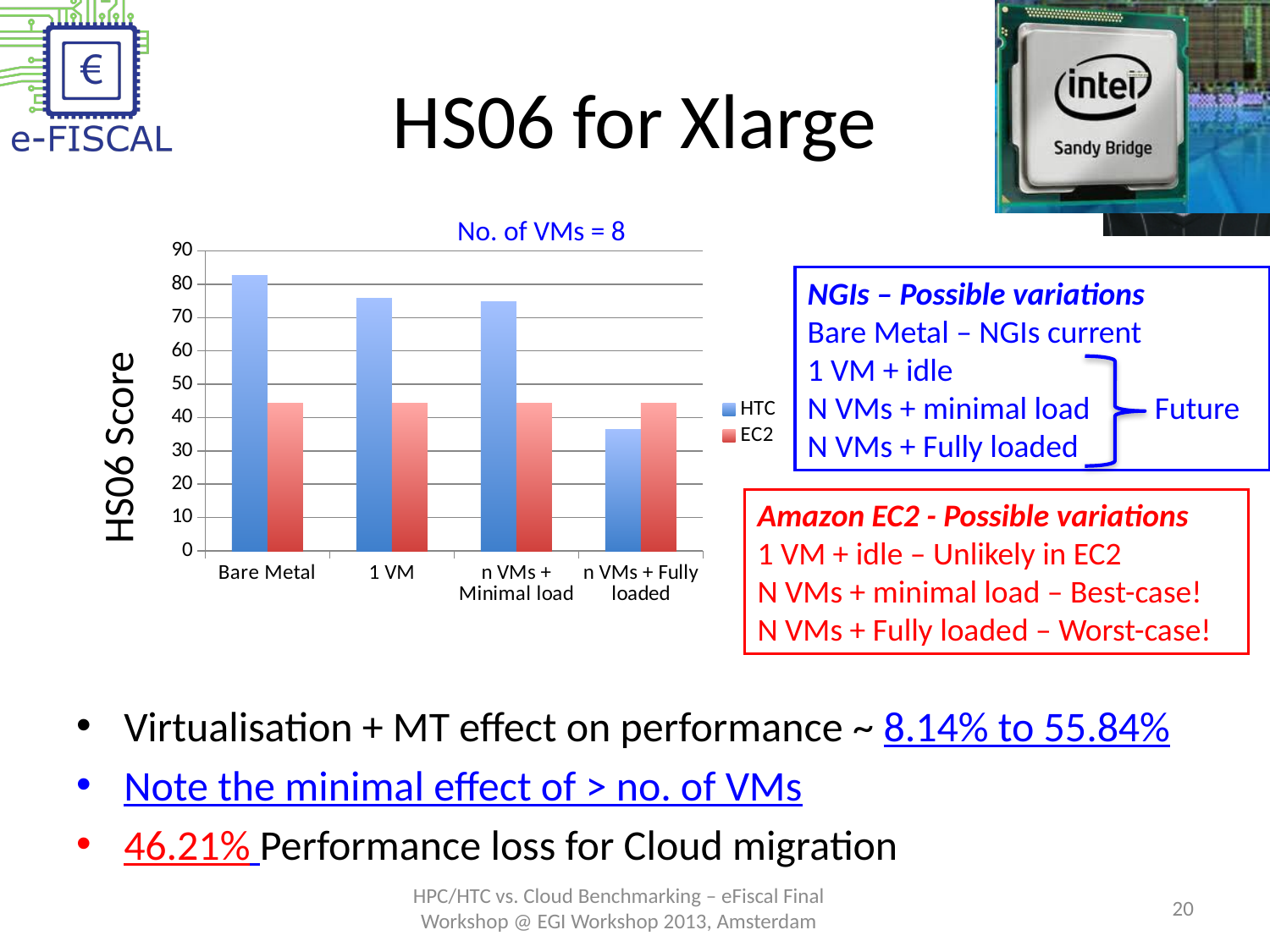
How many categories are shown on the x axis of the chart? 4 Is the EC2 value for 1 VM greater or less than 50? less For Bare Metal, which series has the larger value, HTC or EC2? HTC For n VMs + Fully loaded, which series has the larger value, HTC or EC2? EC2 Do the HTC values rise or fall moving from Bare Metal to n VMs + Fully loaded along the x axis? Fall Which category has the highest HTC value? Bare Metal Which category has the lowest HTC value? n VMs + Fully loaded Is the HTC value for Bare Metal greater or less than 80? greater What is the label on the chart's vertical axis? HS06 Score How many series does the chart's legend list? 2 Is the HTC value for n VMs + Fully loaded greater or less than 40? less What kind of chart is shown on the slide? Bar chart